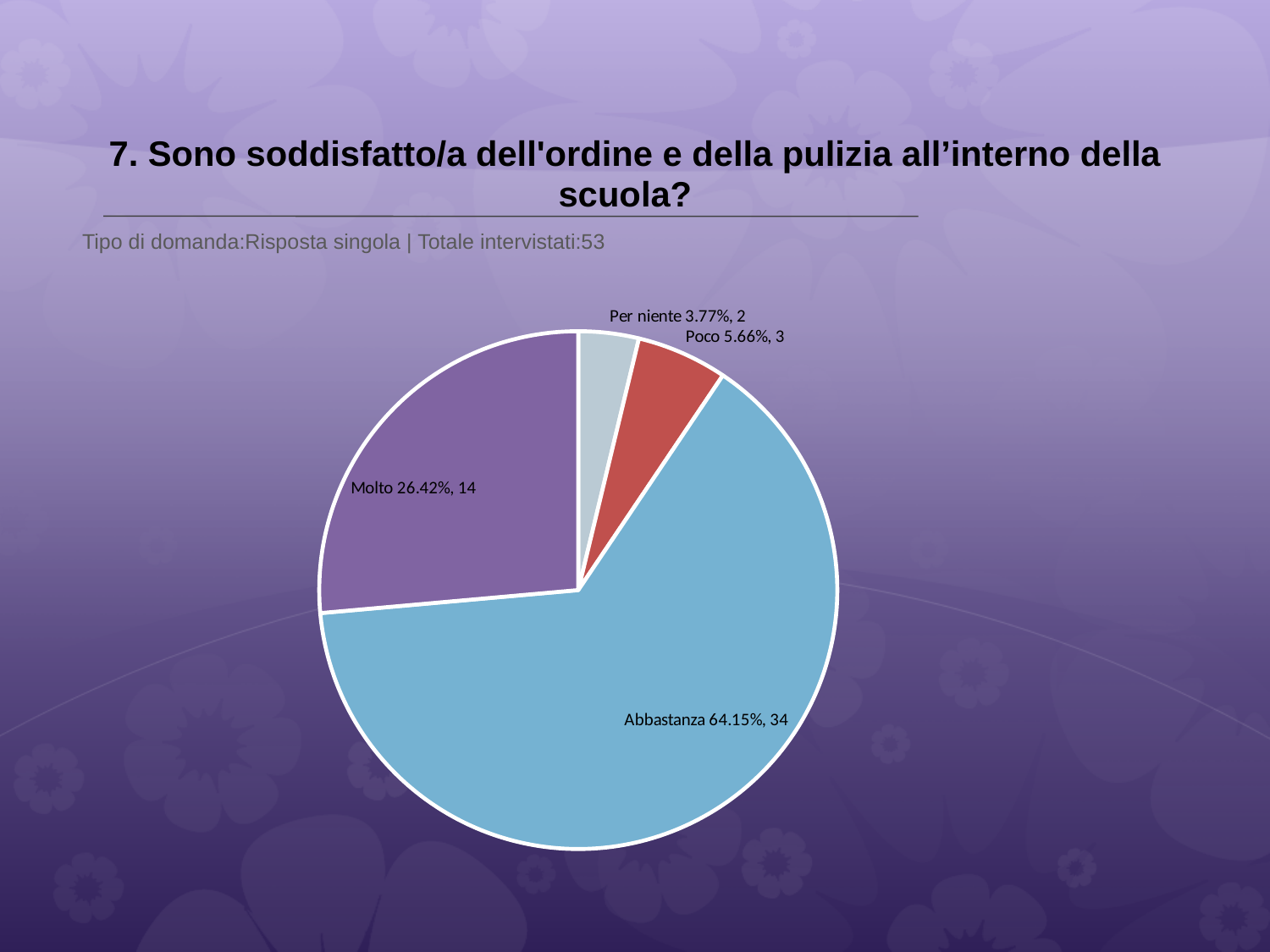
What is the total number of respondents across all slices? 53 Which has more respondents, 'Poco' or 'Per niente'? Poco How many slices does the pie chart have? 4 What colour is the 'Molto' slice? purple How many respondents answered 'Molto'? 14 What is the difference in number of respondents between 'Abbastanza' and 'Molto'? 20 How many respondents answered 'Poco'? 3 What percentage share does the 'Per niente' slice represent? 3.77% Which category has the largest slice of the pie? Abbastanza What type of chart is shown on the slide? pie chart Which category has the smallest slice of the pie? Per niente What percentage share does the 'Abbastanza' slice represent? 64.15%